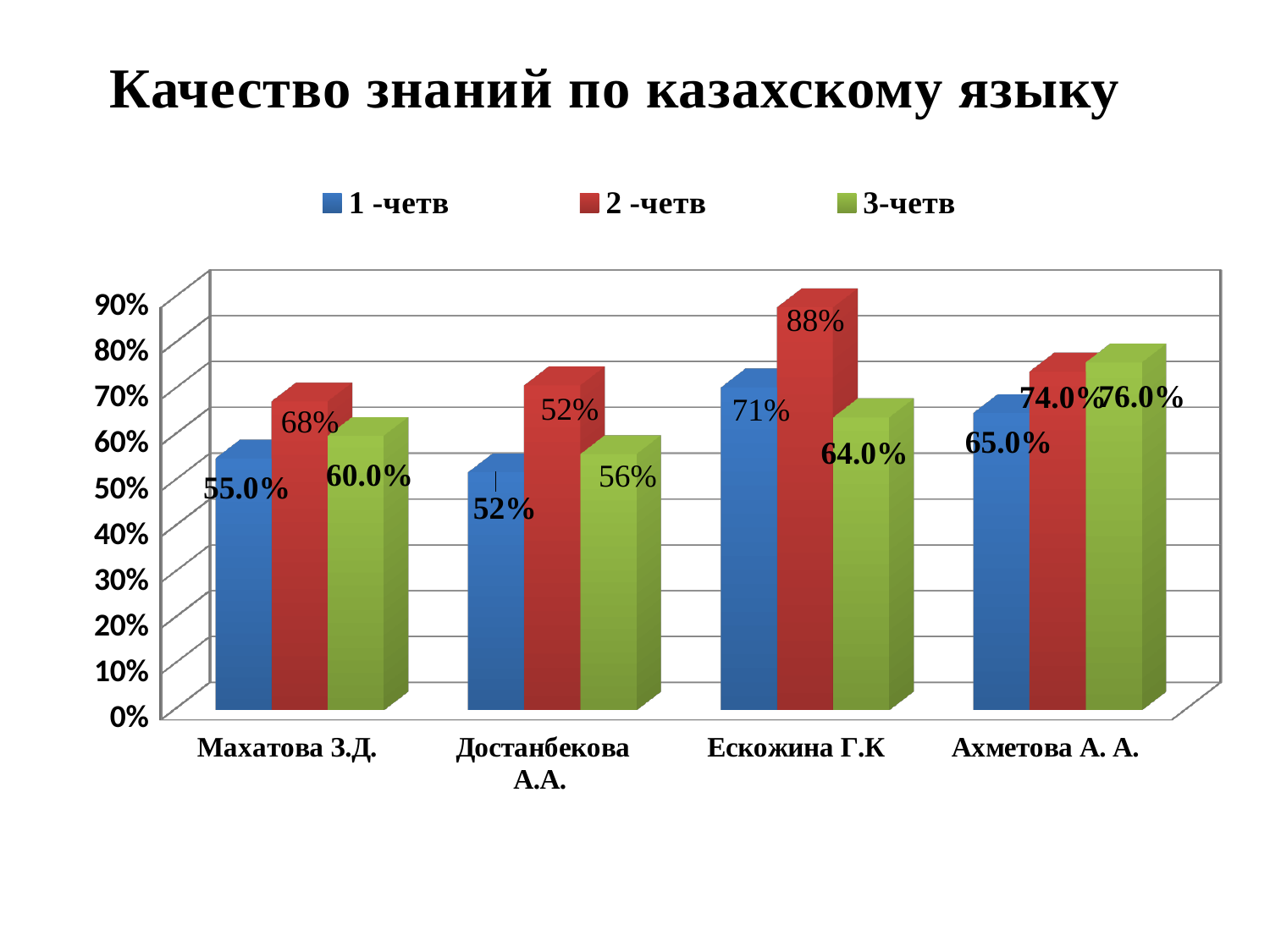
How many teachers are shown on the x axis? 4 What is the value for Ахметова А. А. in the 3-четв series? 76.0% What is the title of the chart? Качество знаний по казахскому языку Which teacher has the highest value in the 2 -четв series? Ескожина Г.К How many series does the legend list? 3 What is the value for Махатова З.Д. in the 1 -четв series? 55.0% What is the value for Ескожина Г.К in the 2 -четв series? 88% Which teacher has the lowest value in the 1 -четв series? Достанбекова А.А. Which is larger for Ахметова А. А.: the 1 -четв value or the 3-четв value? 3-четв What is the difference between the 2 -четв and 1 -четв values for Ескожина Г.К? 17% What is the value for Достанбекова А.А. in the 3-четв series? 56% What kind of chart is shown on the slide? Bar chart